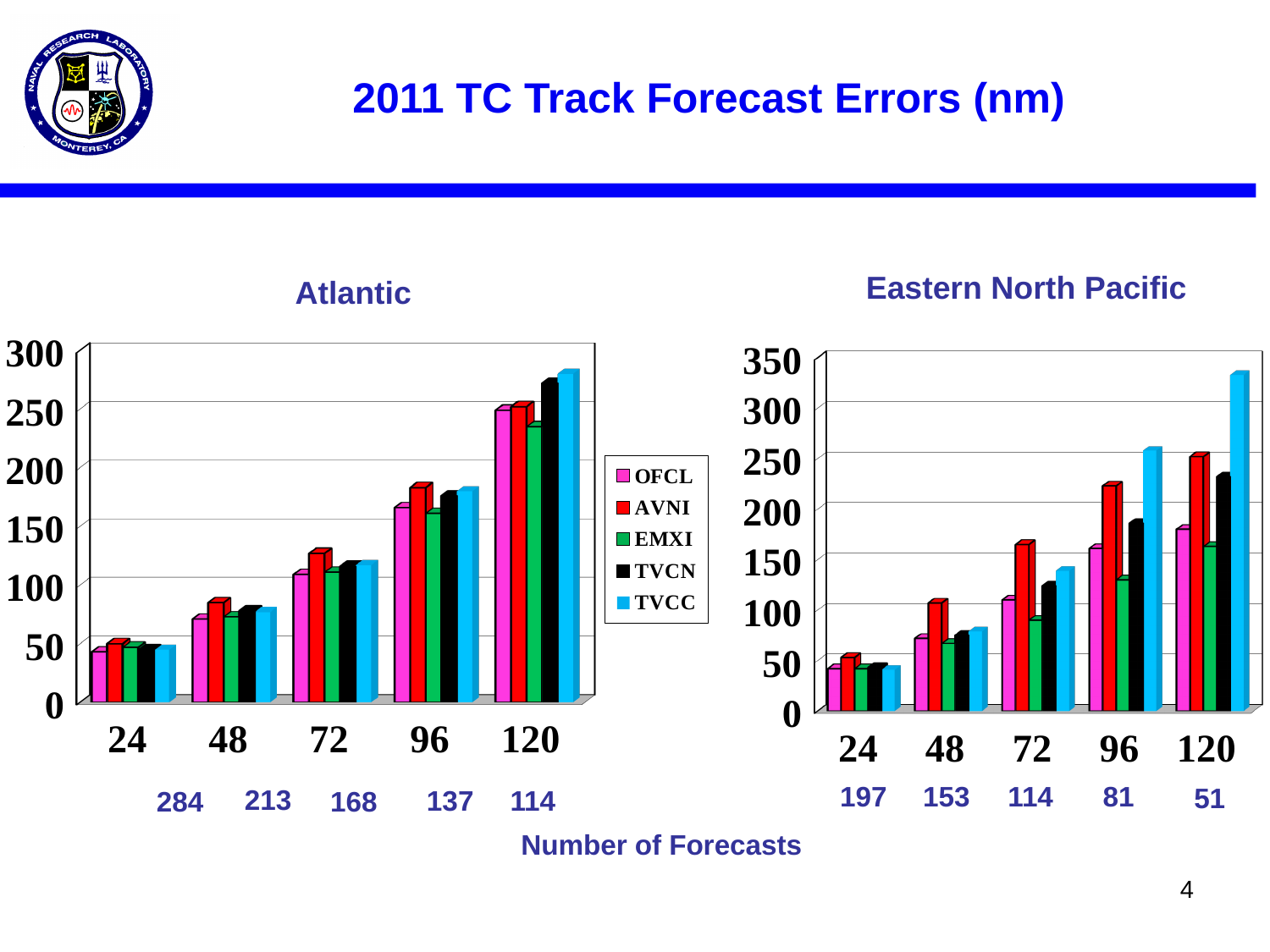
In the Eastern North Pacific chart, which is larger at 72 hours: AVNI or EMXI? AVNI How many series does the legend list? 5 What is the number of forecasts printed under the 120-hour category of the Eastern North Pacific chart? 51 What is the number of forecasts printed under the 24-hour category of the Atlantic chart? 284 In the Eastern North Pacific chart, which series has the lowest value at 120 hours? EMXI In the Atlantic chart, is the value for TVCC at 120 hours greater or less than 250? greater How many forecast-hour categories are shown on the Eastern North Pacific chart? 5 In the Eastern North Pacific chart, which series has the highest value at 120 hours? TVCC In the Atlantic chart, do the forecast errors rise or fall as the forecast hour increases from 24 to 120? rise In the Eastern North Pacific chart, is the value for TVCC at 120 hours greater or less than 300? greater What type of chart is the Atlantic chart? bar chart In the Atlantic chart, is the value for AVNI at 72 hours greater or less than 100? greater